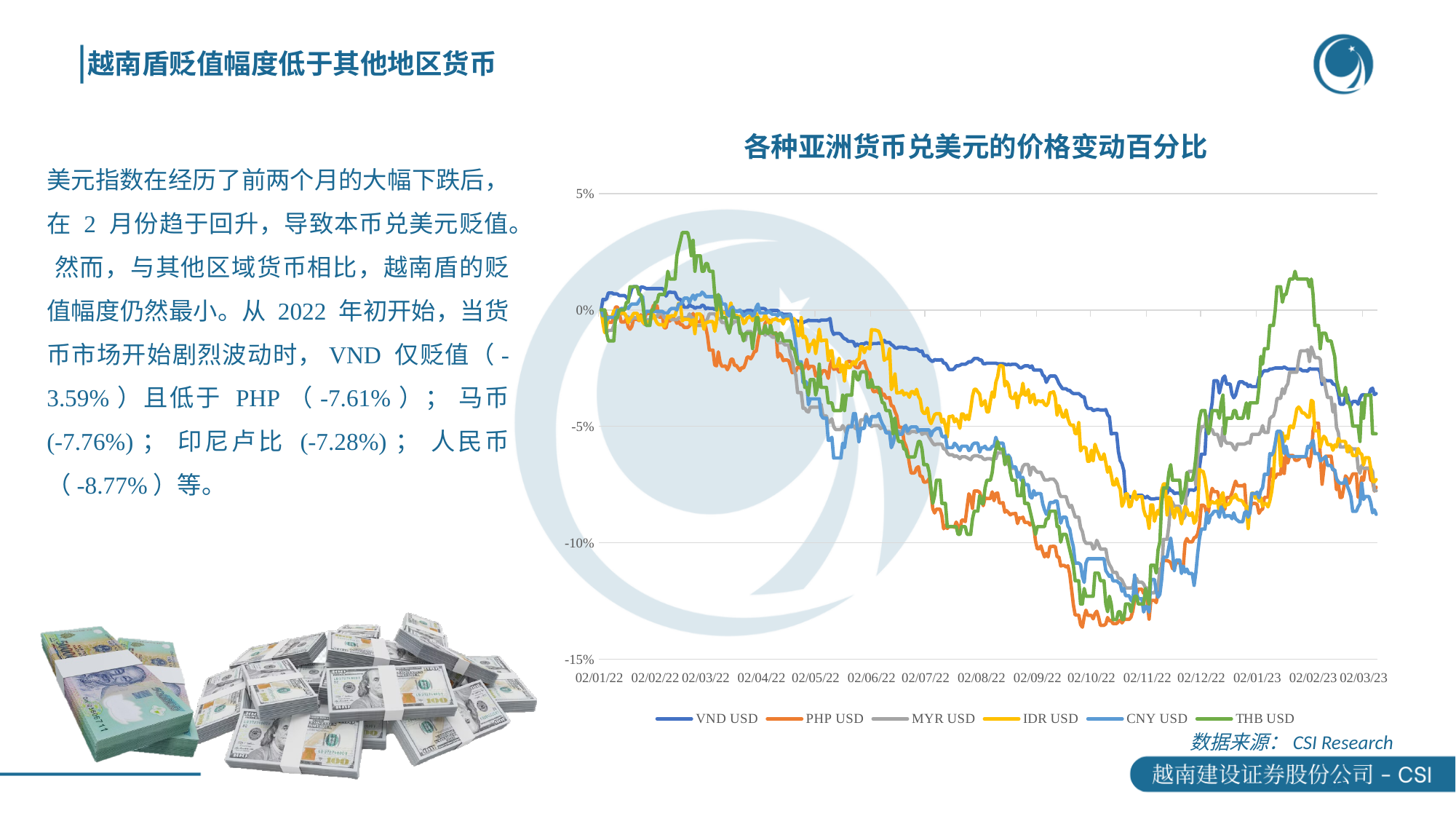
Is the value for VND USD at 02/03/23 greater or less than -5%? greater Which series is listed first in the chart legend? VND USD At 02/11/22, which series has the higher value, VND USD or PHP USD? VND USD Is the value for CNY USD at 02/03/23 greater or less than -5%? less How many series does the legend of the chart list? 6 Does the THB USD line rise or fall between 02/11/22 and 02/02/23? rise Is the highest point reached by THB USD greater or less than 0%? greater How many date labels are shown on the x axis of the chart? 15 What kind of chart is shown on the slide? line chart Does the VND USD line rise or fall between 02/01/22 and 02/11/22? fall What is the title of the chart? 各种亚洲货币兑美元的价格变动百分比